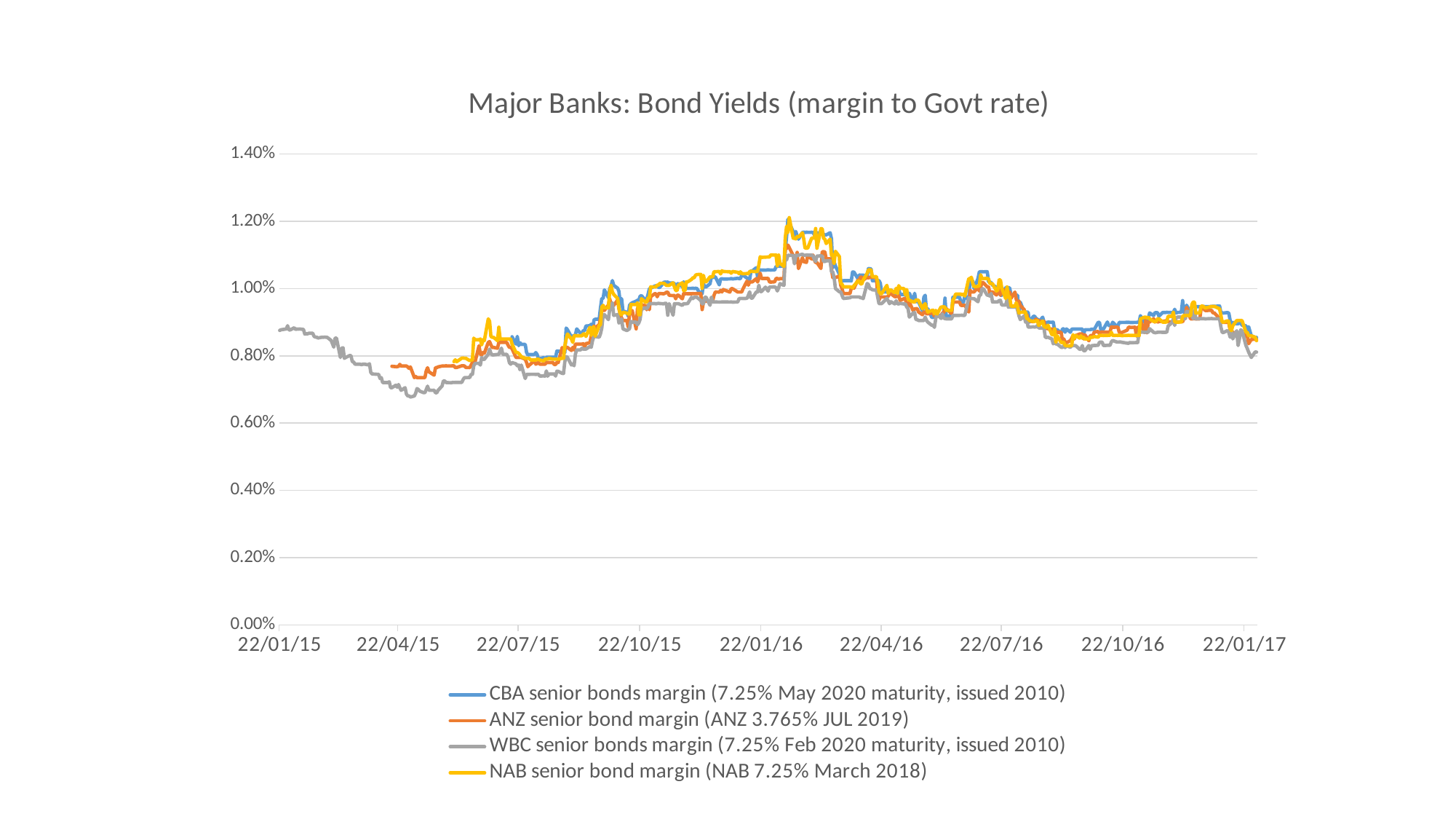
How many series does the legend list? 4 What is the title of the chart? Major Banks: Bond Yields (margin to Govt rate) What is the highest value shown on the vertical axis? 1.40% Is the peak value of the CBA senior bonds margin series around early 2016 greater or less than 1.00%? greater What kind of chart is shown on the slide? line chart Is the value of the CBA senior bonds margin series at 22/01/17 greater or less than 1.00%? less Do the series generally rise or fall between 22/07/15 and 22/01/16? rise Does the WBC senior bonds margin series rise or fall between 22/01/15 and 22/04/15? fall Which colour is used for the NAB senior bond margin series? yellow Which series is lower around 22/04/15, WBC senior bonds margin or ANZ senior bond margin? WBC senior bonds margin Is the value of the WBC senior bonds margin series around 22/04/15 greater or less than 0.80%? less